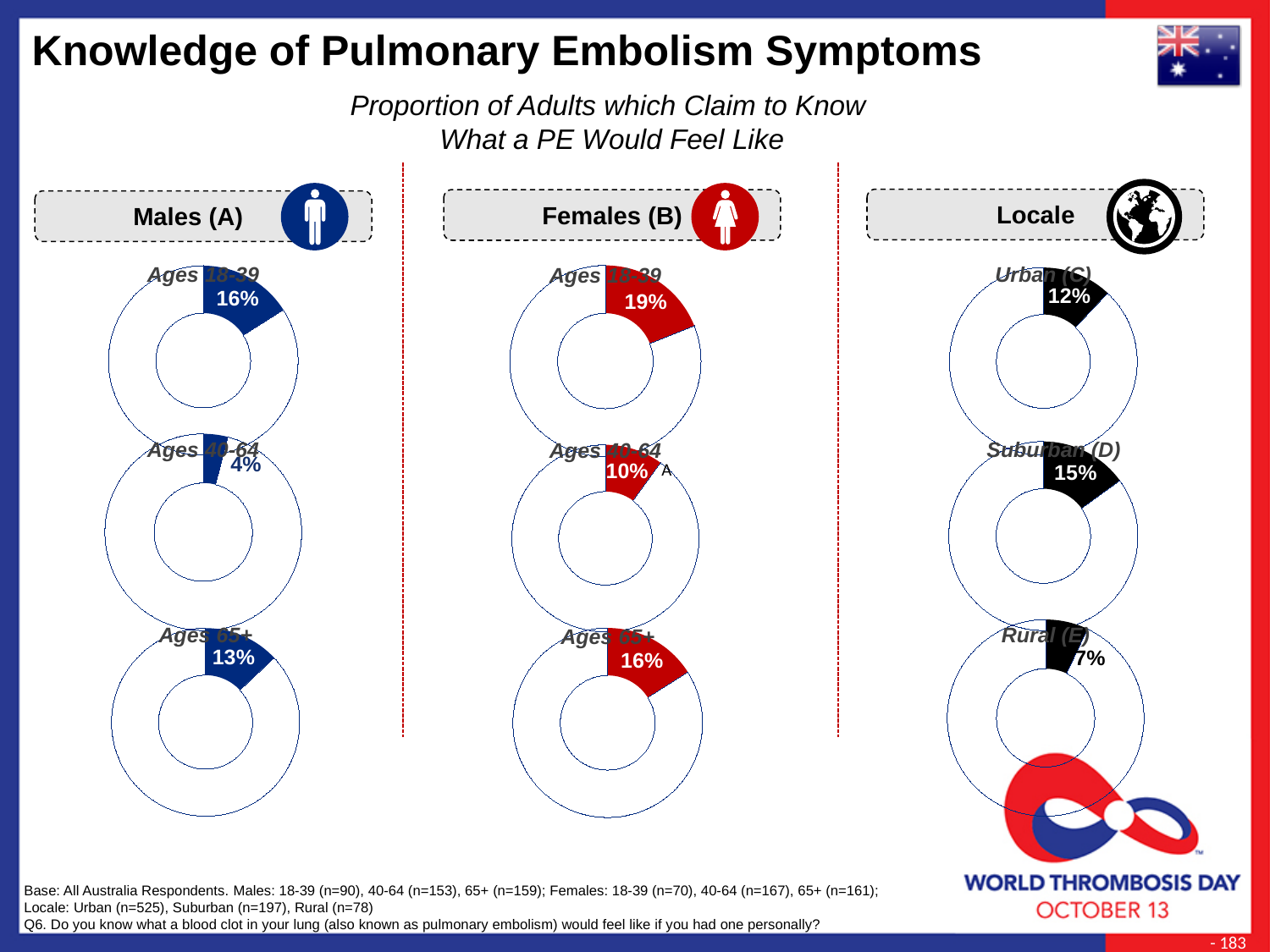
In the Females (B) Ages 18-39 donut chart, what value is shown? 19% What type of chart is used to show each value on this slide? Donut chart In the Males (A) Ages 18-39 donut chart, what proportion of adults claim to know what a PE would feel like? 16% In the Males (A) Ages 40-64 donut chart, what value is shown? 4% In the Females (B) Ages 65+ donut chart, what value is shown? 16% Among the three Females (B) donut charts, which age group shows the highest value? Ages 18-39 Among the three Males (A) donut charts, which age group shows the lowest value? Ages 40-64 How many donut charts are shown on the slide in total? 9 In the Locale Rural (E) donut chart, what value is shown? 7% Which is larger: the Locale Urban (C) value or the Locale Rural (E) value? Urban (C) What is the difference between the Females (B) Ages 40-64 value and the Males (A) Ages 40-64 value? 6% Among the three Locale donut charts, which locale shows the highest value? Suburban (D)